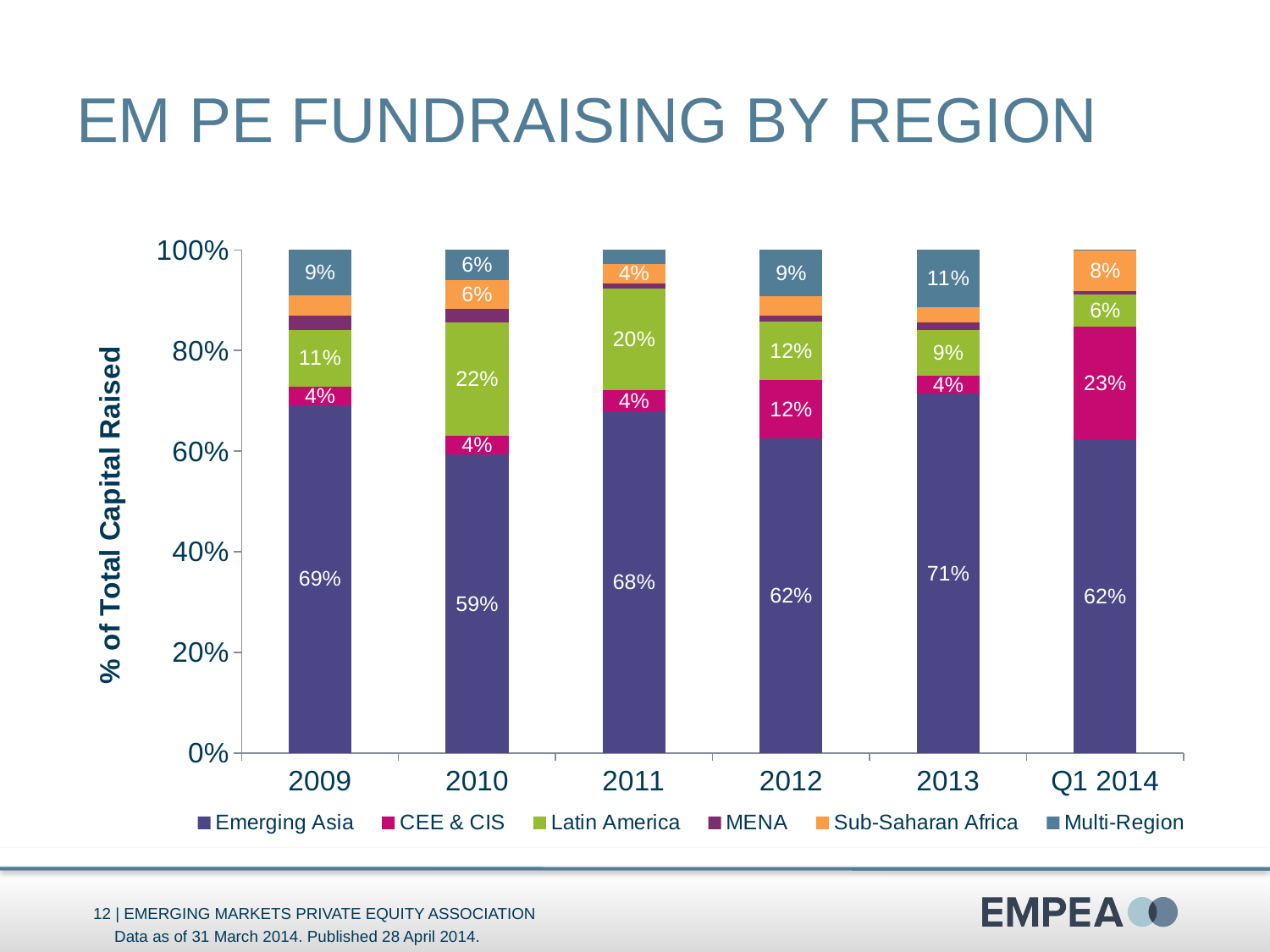
How many time periods are shown on the x axis? 6 What share of total capital raised did Multi-Region funds account for in 2012? 9% Which had a larger share of total capital raised in 2012: CEE & CIS or Multi-Region? CEE & CIS What type of chart is shown on the slide? Stacked bar chart By how many percentage points did Latin America's share fall from 2010 to 2013? 13 percentage points In which year did Emerging Asia have its highest share of total capital raised? 2013 What percentage of total capital raised went to CEE & CIS in Q1 2014? 23% What is the label of the y axis? % of Total Capital Raised How many regions does the legend list? 6 What share of total capital raised did Emerging Asia account for in 2013? 71% In which year did Emerging Asia have its lowest share of total capital raised? 2010 What was Latin America's share of total capital raised in 2010? 22%